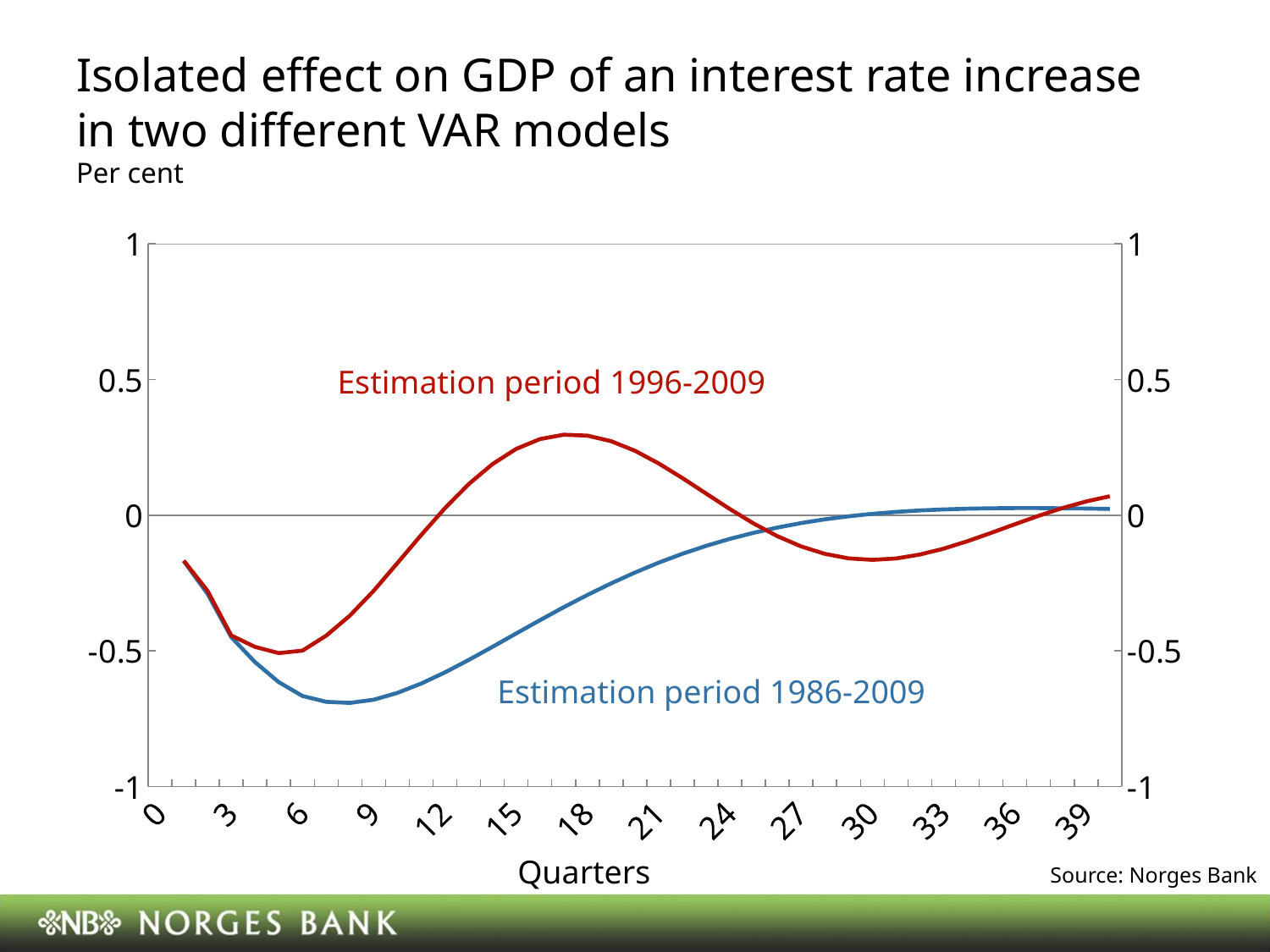
At quarter 30, which line is higher: 'Estimation period 1996-2009' or 'Estimation period 1986-2009'? Estimation period 1986-2009 At quarter 18, which line is higher: 'Estimation period 1996-2009' or 'Estimation period 1986-2009'? Estimation period 1996-2009 What is the source given for the chart? Norges Bank How many series are plotted on the chart? 2 Is the value of the 'Estimation period 1996-2009' line at quarter 30 greater or less than 0? less What is the label of the x axis? Quarters Is the value of the 'Estimation period 1986-2009' line at quarter 9 greater or less than -0.5? less Does the 'Estimation period 1986-2009' line rise or fall between quarter 9 and quarter 27? rise What kind of chart is shown on the slide? line chart Which series reaches the lowest value on the chart? Estimation period 1986-2009 Is the value of the 'Estimation period 1996-2009' line at quarter 18 greater or less than 0? greater